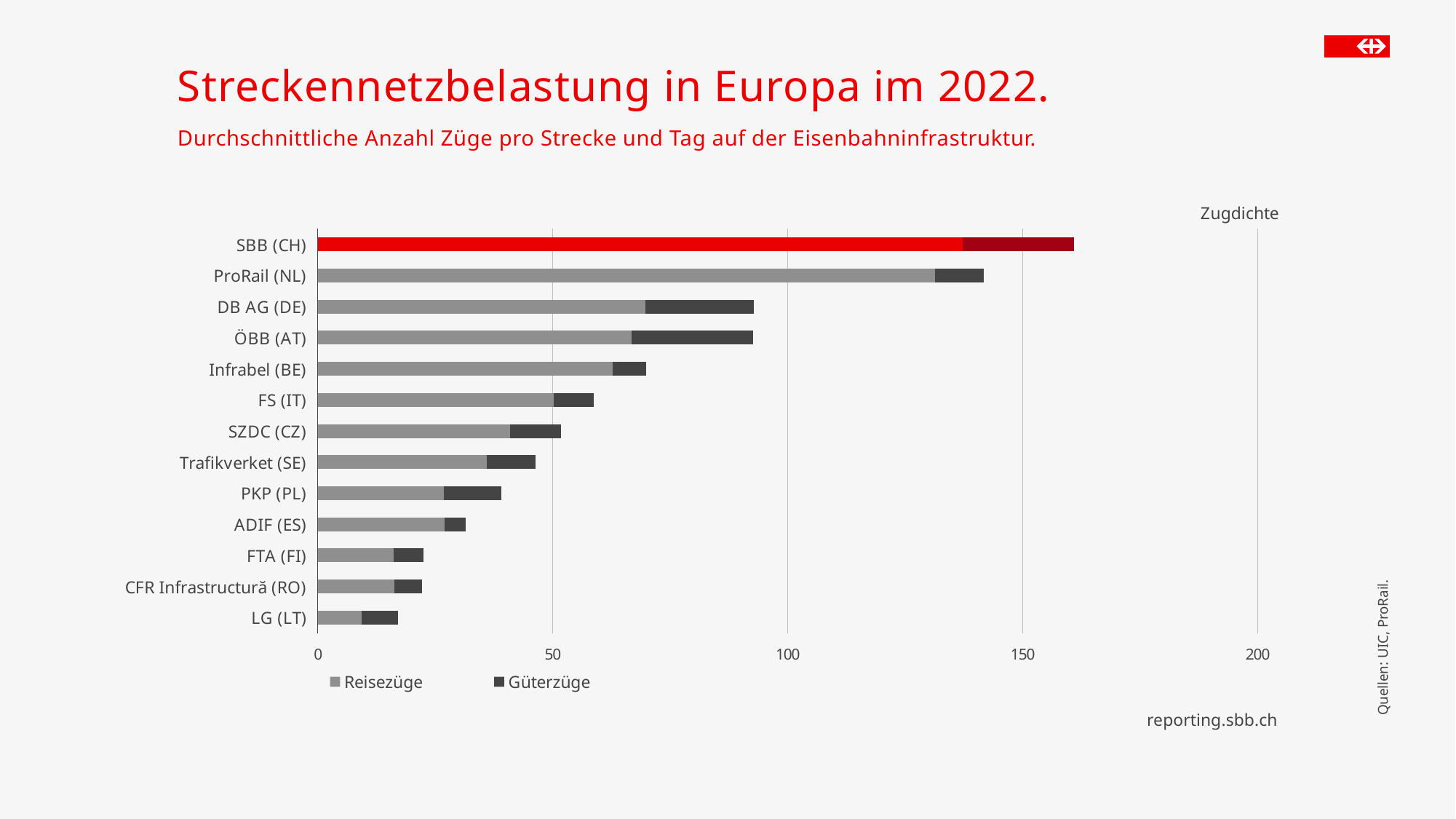
What kind of chart is shown on the slide? bar chart How many railway operators (categories) are listed on the chart? 13 Which has the larger total train density, SBB (CH) or ProRail (NL)? SBB (CH) Which operator has the lowest total train density (Zugdichte)? LG (LT) What are the two series named in the legend? Reisezüge and Güterzüge Is the total value for ProRail (NL) greater or less than 150? less How many series does the legend list? 2 Is the total value for SBB (CH) greater or less than 150? greater Is the total value for Trafikverket (SE) greater or less than 50? less Which operator has the highest total train density (Zugdichte)? SBB (CH) Which has the larger total train density, Infrabel (BE) or FS (IT)? Infrabel (BE)